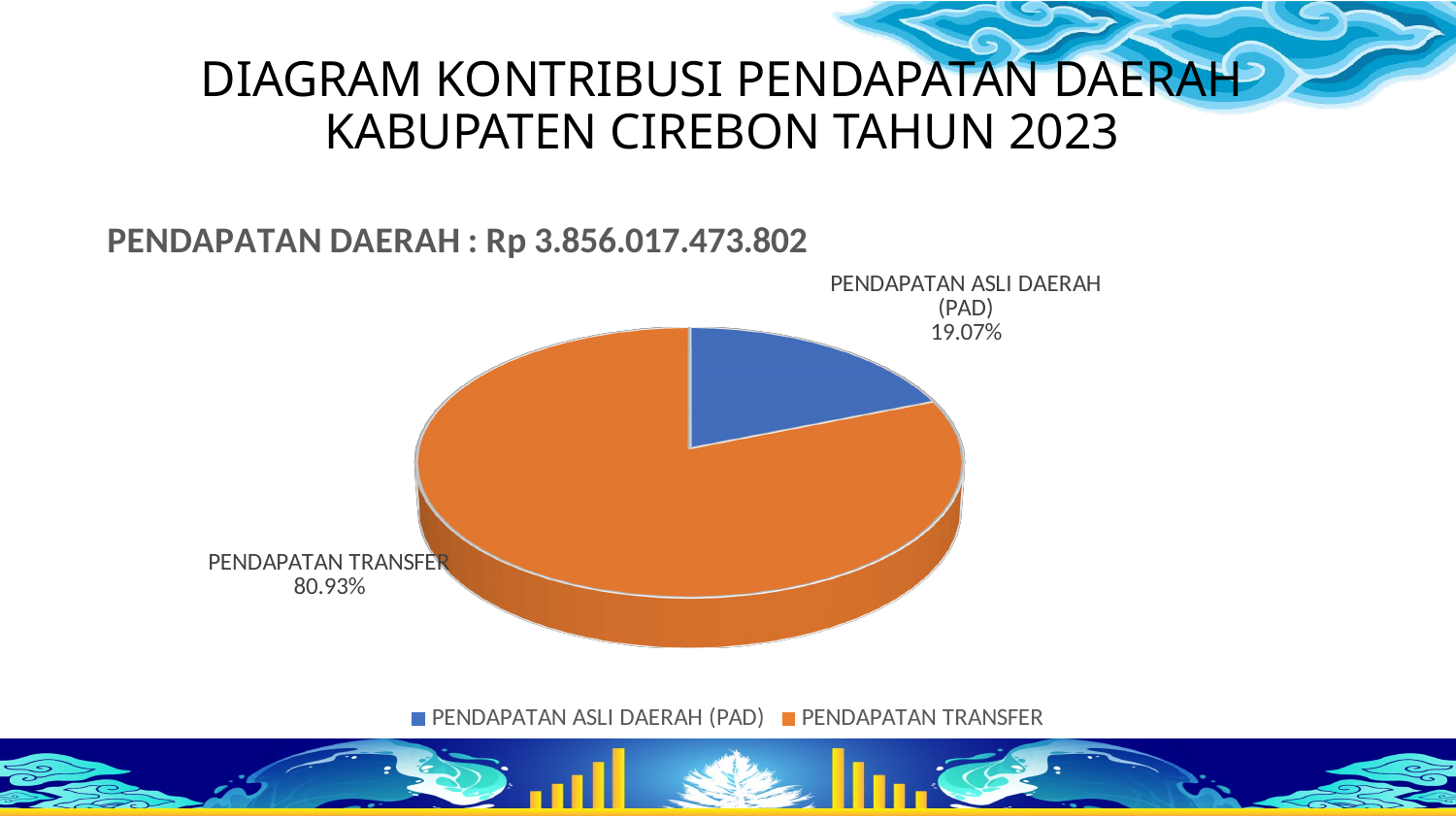
Which slice of the pie is the smallest? PENDAPATAN ASLI DAERAH (PAD) What colour is the PENDAPATAN TRANSFER slice? orange What kind of chart is shown on the slide? pie chart Which is larger, the share for PENDAPATAN ASLI DAERAH (PAD) or the share for PENDAPATAN TRANSFER? PENDAPATAN TRANSFER What share of the pie does PENDAPATAN ASLI DAERAH (PAD) represent? 19.07% How many slices does the pie chart have? 2 How many entries does the legend list? 2 What is the difference in percentage points between PENDAPATAN TRANSFER and PENDAPATAN ASLI DAERAH (PAD)? 61.86 Which slice of the pie is the largest? PENDAPATAN TRANSFER What share of the pie does PENDAPATAN TRANSFER represent? 80.93% What total PENDAPATAN DAERAH value is stated above the chart? Rp 3.856.017.473.802